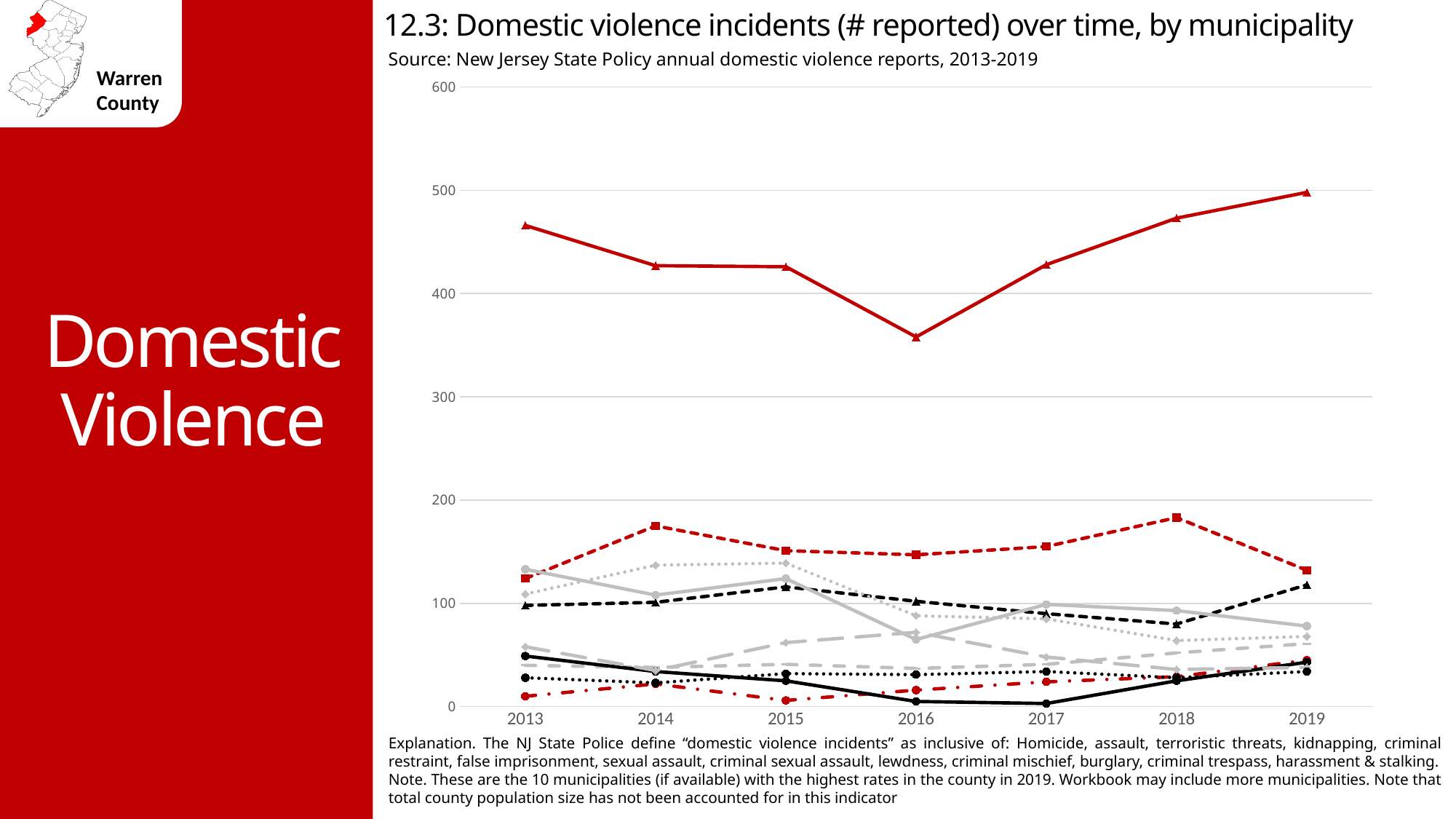
Does the topmost (solid red) line rise or fall from 2016 to 2019? rise In which year does the topmost (solid red) line reach its lowest value? 2016 Is the value of the topmost (solid red) line in 2013 greater or less than 400? greater What kind of chart is shown on the slide? line chart What is the title of the chart? 12.3: Domestic violence incidents (# reported) over time, by municipality Is the value of the topmost (solid red) line in 2019 greater or less than 450? greater How many years are shown along the x axis of the chart? 7 Is the value of the topmost (solid red) line in 2016 greater or less than 400? less What range of years does the source cited for the chart cover? 2013-2019 In which year does the topmost (solid red) line reach its highest value? 2019 What is the highest value shown on the y axis of the chart? 600